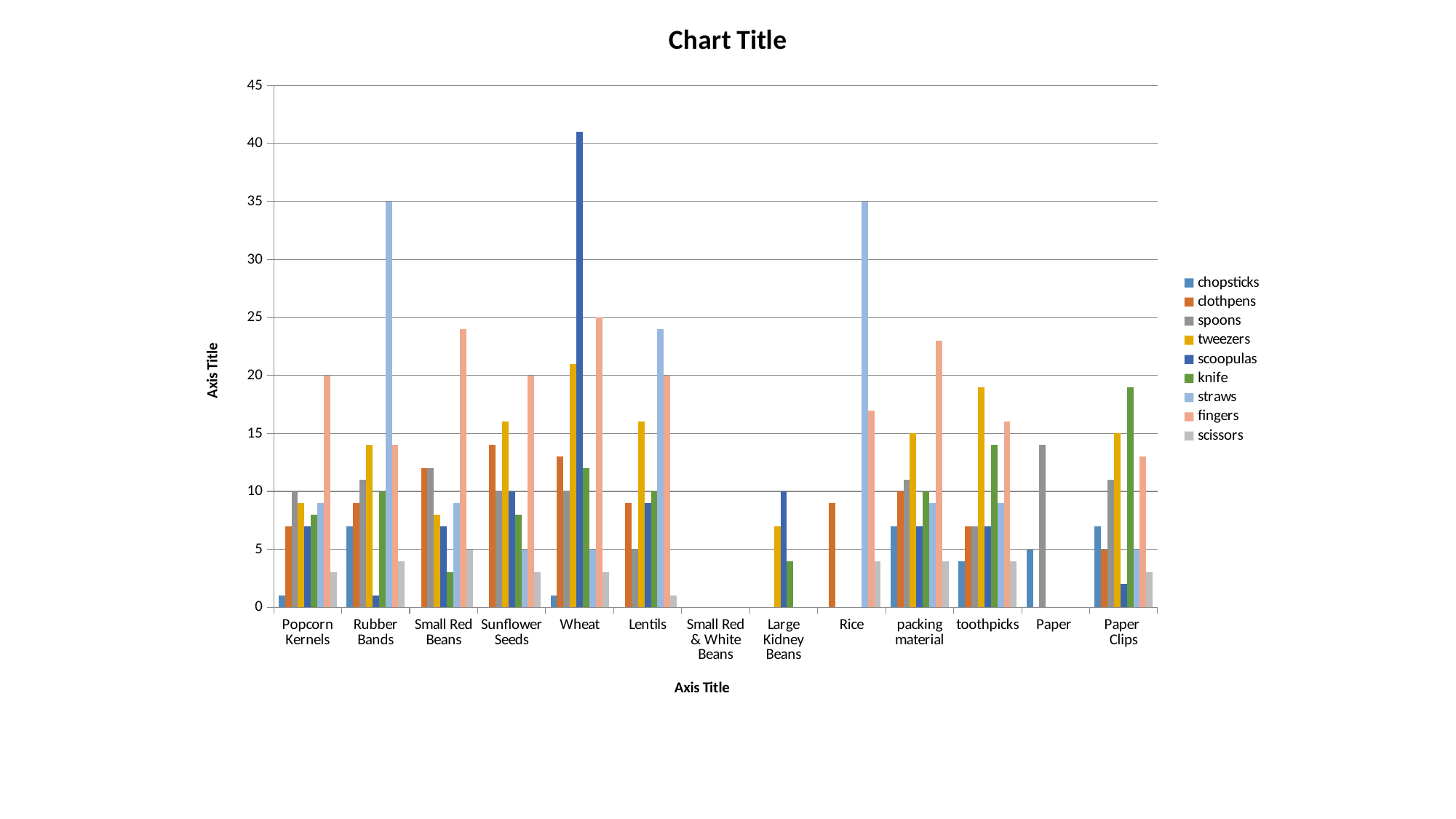
Which series has the tallest bar in the Wheat category? scoopulas What is the value for fingers in the Wheat category? 25 In the Rubber Bands category, which is larger: the straws bar or the fingers bar? straws What is the value for scoopulas in the Large Kidney Beans category? 10 What is the value for straws in the Rubber Bands category? 35 What is the value for chopsticks in the Paper category? 5 What is the title of the chart? Chart Title What kind of chart is shown on the slide? bar chart Is the value for fingers in the Small Red Beans category greater or less than 20? greater How many series does the legend list? 9 Is the value for scoopulas in the Wheat category greater or less than 40? greater How many categories are shown along the x axis? 13